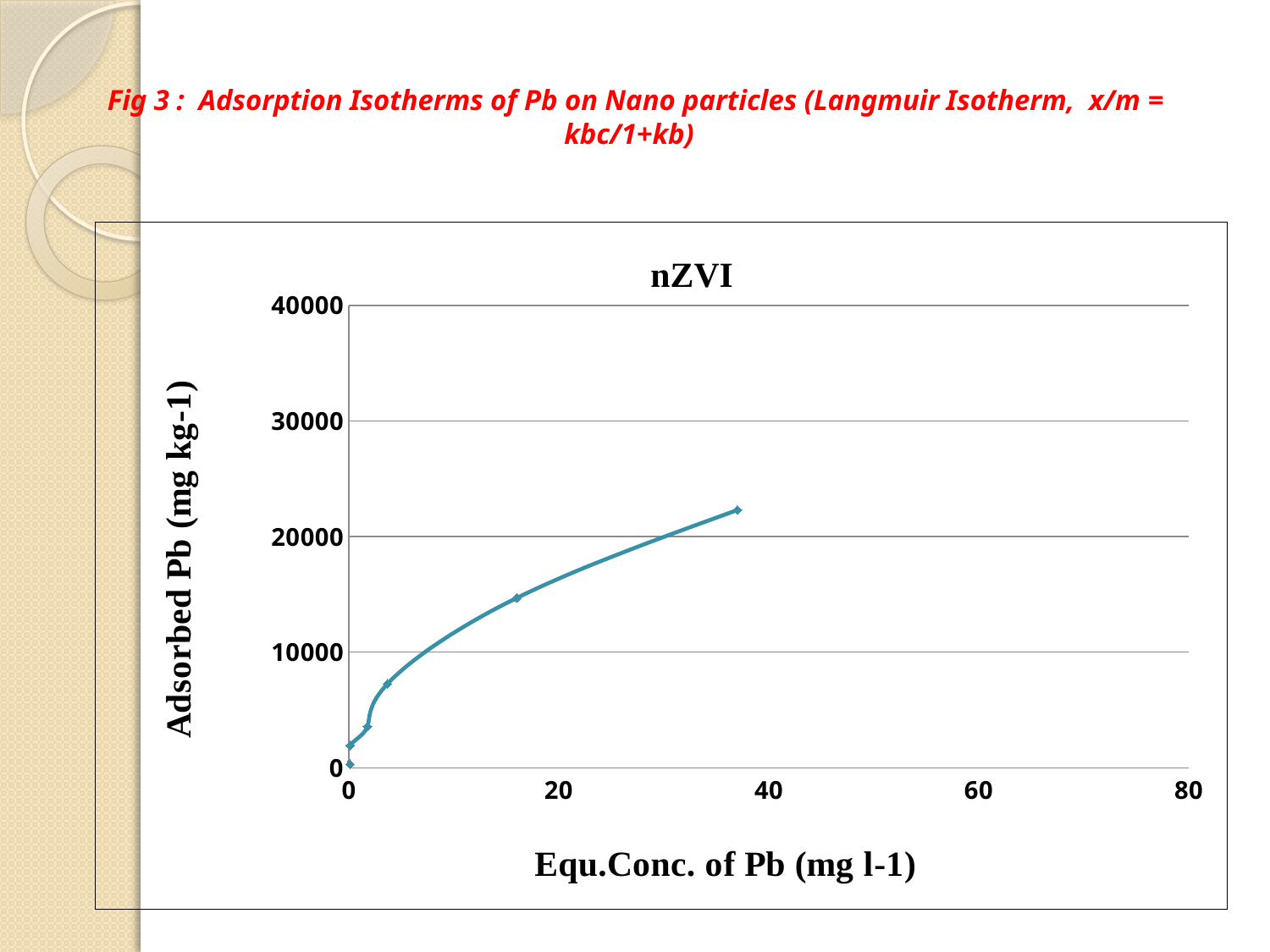
Is the highest plotted value of Adsorbed Pb greater or less than 20000? greater Is the Adsorbed Pb value at the point near an Equ.Conc. of about 16 mg l-1 greater or less than 10000? greater What is the label of the y axis? Adsorbed Pb (mg kg-1) Is the highest plotted value of Adsorbed Pb greater or less than 30000? less What is the maximum value shown on the y axis? 40000 What is the title of the chart? nZVI Do the values of Adsorbed Pb rise or fall as Equ.Conc. of Pb increases along the x axis? rise How many data points are plotted on the chart? 6 What kind of chart is shown on the slide? line chart